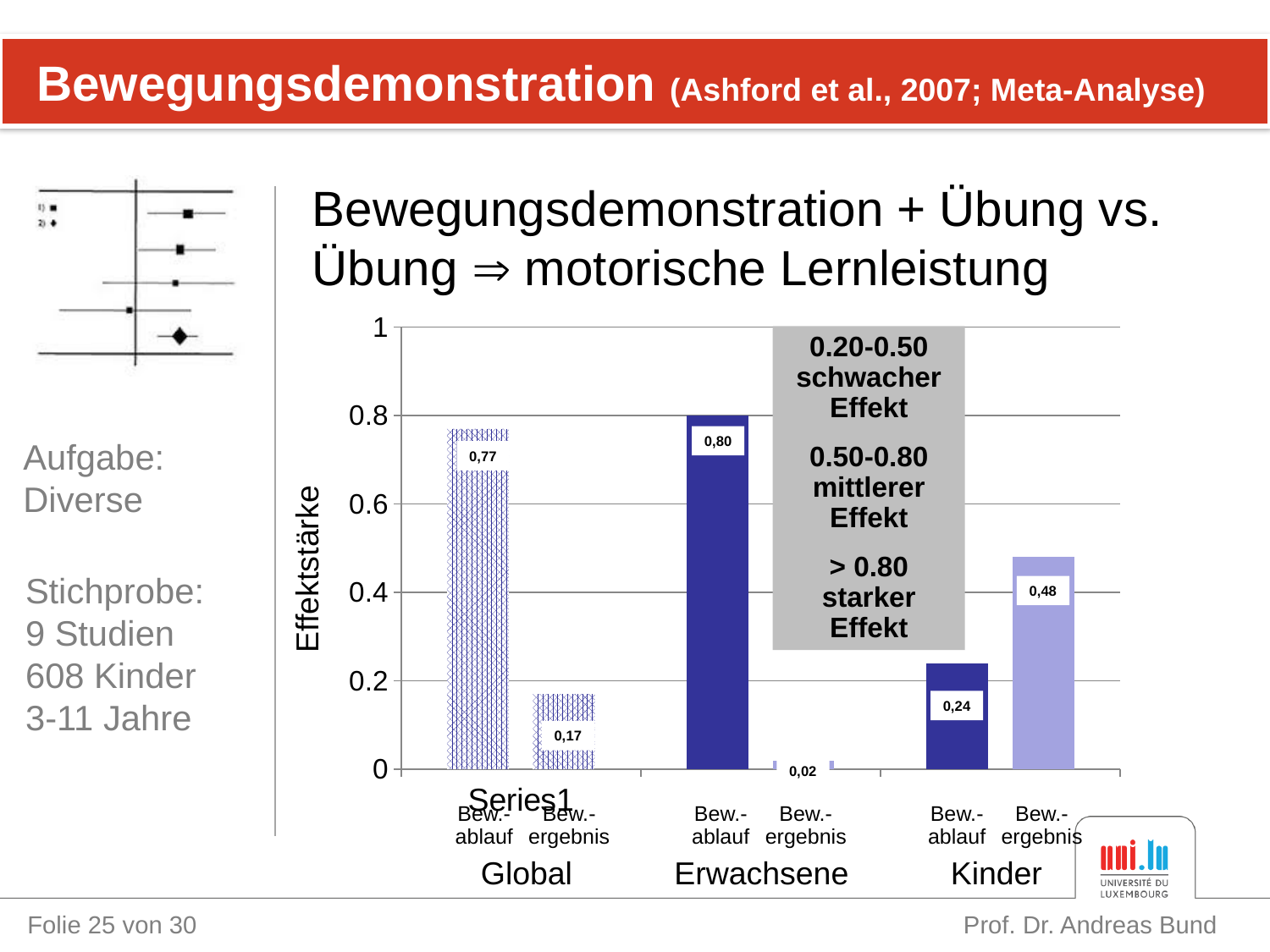
Which bar has the highest effect size in the chart? Erwachsene Bew.-ablauf (0,80) What type of chart is shown on the slide? bar chart What is the effect size for Bew.-ergebnis in the Kinder group? 0,48 What is the label of the y-axis of the chart? Effektstärke What is the effect size for Bew.-ablauf in the Kinder group? 0,24 Which bar has the lowest effect size in the chart? Erwachsene Bew.-ergebnis (0,02) In the Kinder group, which is larger: the effect size for Bew.-ablauf or for Bew.-ergebnis? Bew.-ergebnis What is the effect size (Effektstärke) for Bew.-ablauf in the Global group? 0,77 How many bars are plotted in the chart? 6 Is the effect size for Bew.-ablauf in the Erwachsene group greater or less than 0.6? greater What is the difference between the Bew.-ablauf and Bew.-ergebnis effect sizes in the Global group? 0,60 What is the effect size for Bew.-ergebnis in the Erwachsene group? 0,02